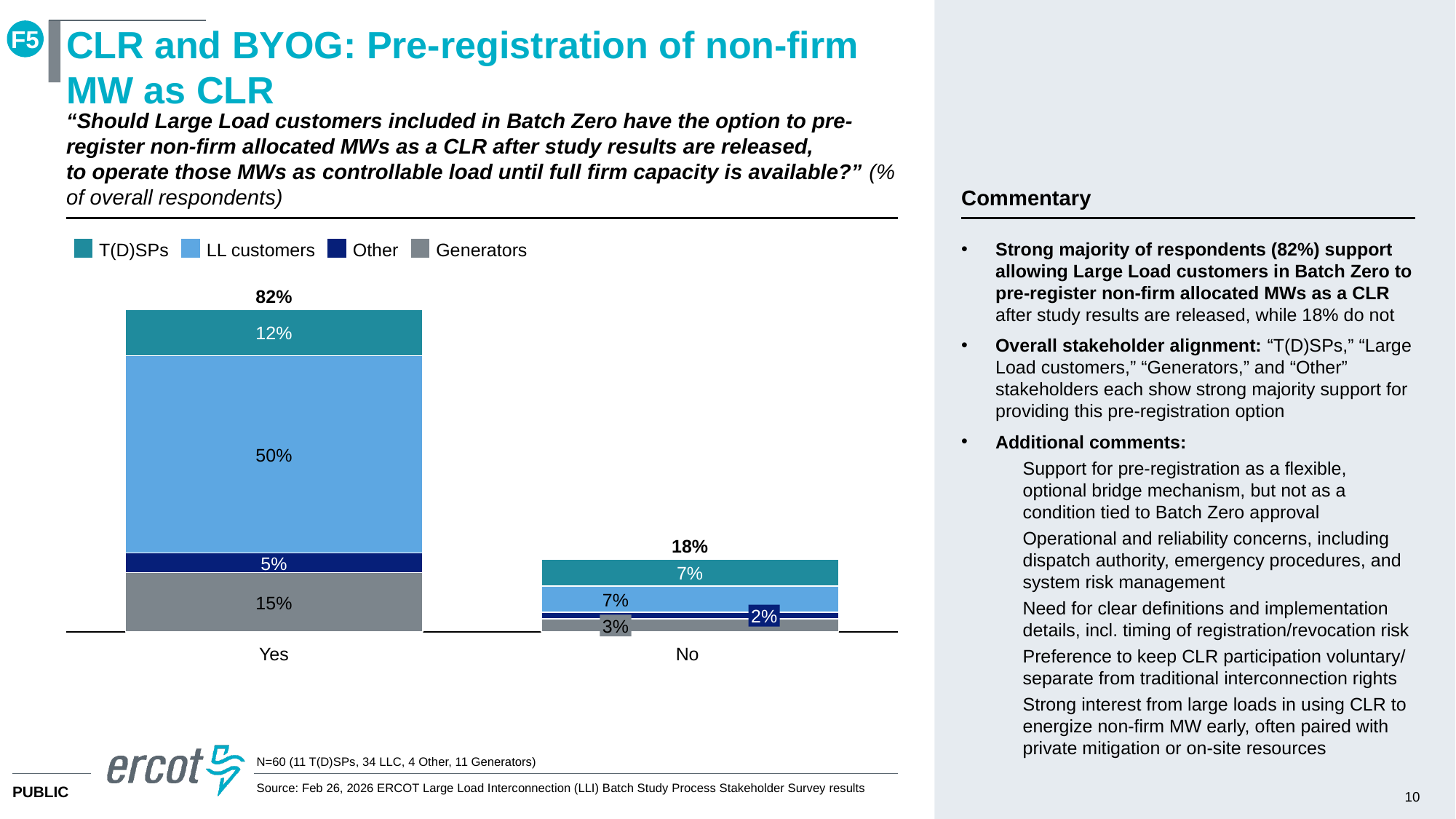
What is the total for the Yes bar? 82% How many categories are shown on the x axis? 2 What is the value for LL customers in the Yes bar? 50% What is the value for Generators in the Yes bar? 15% What kind of chart is shown on the slide? Stacked bar chart Which category has the higher total, Yes or No? Yes What is the value for Other in the No bar? 2% Which series has the largest segment in the Yes bar? LL customers How many series does the legend list? 4 What is the value for T(D)SPs in the No bar? 7% What is the total for the No bar? 18% What is the difference between the Yes total and the No total? 64%